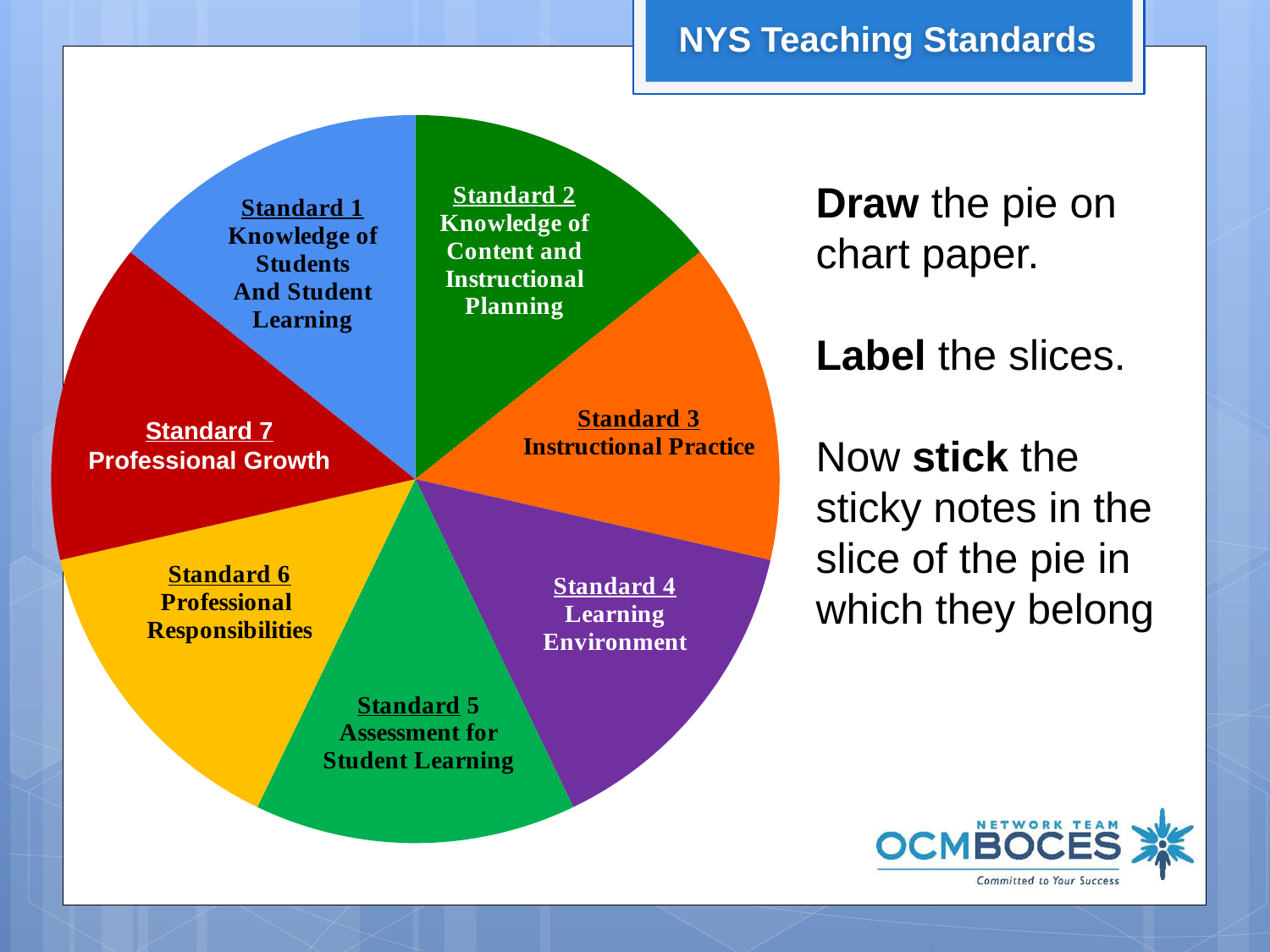
What is the label of the slice for Standard 2? Knowledge of Content and Instructional Planning What colour is the slice for Standard 7 Professional Growth? red How many slices does the pie chart have? 7 What is the title shown above the pie chart? NYS Teaching Standards What kind of chart is shown on the slide? pie chart What is the label of the slice for Standard 1? Knowledge of Students And Student Learning Which standard number is labeled 'Instructional Practice' in the pie chart? Standard 3 What is the label of the slice for Standard 6? Professional Responsibilities What is the label of the slice for Standard 5? Assessment for Student Learning Which standard number is labeled 'Learning Environment' in the pie chart? Standard 4